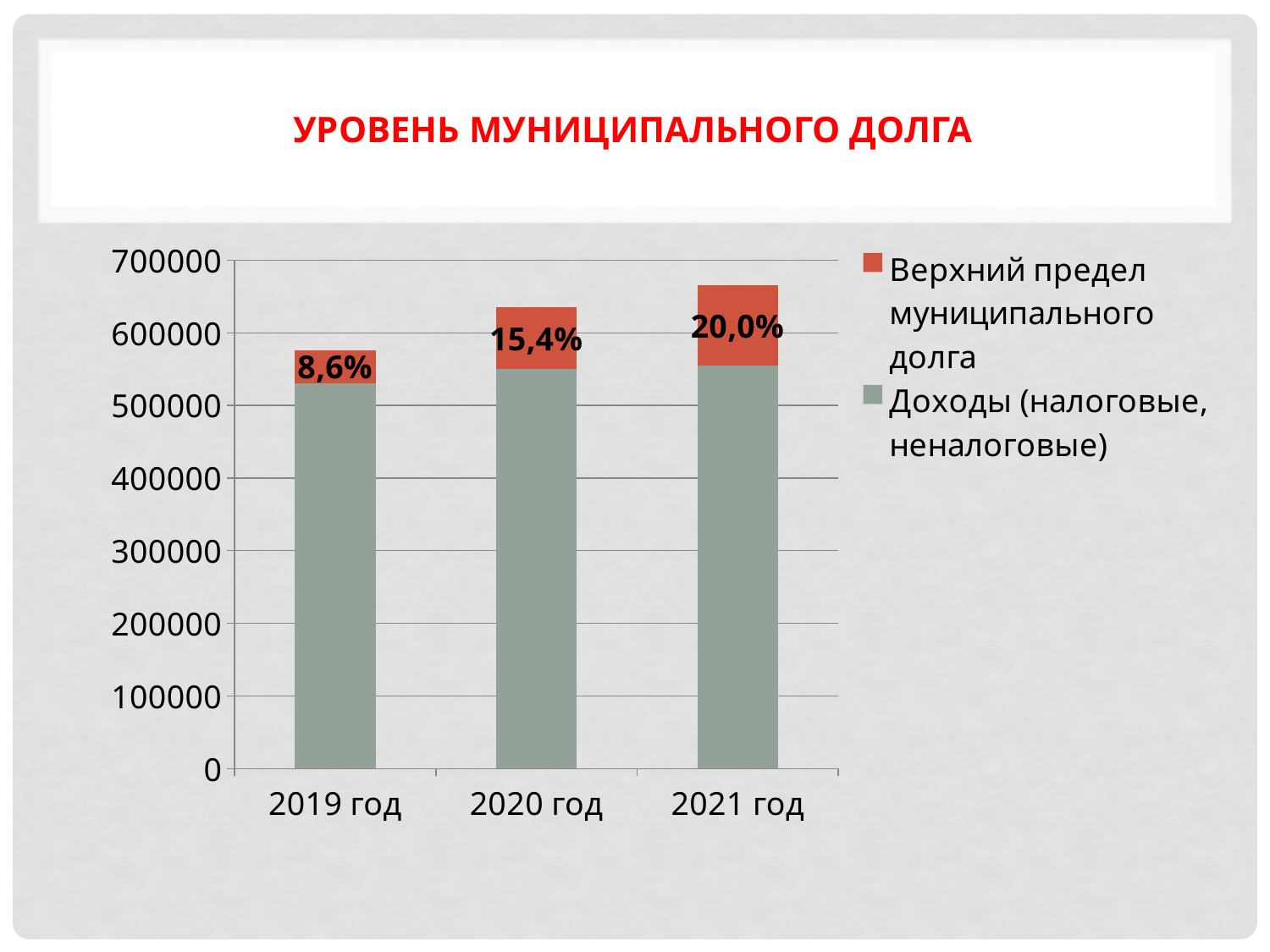
How many years (categories) are shown on the x axis? 3 Is the total height of the stacked bar for 2019 год greater or less than 600000? less Which year has the shortest stacked bar overall? 2019 год Do the percentage labels on the bars rise or fall from 2019 год to 2021 год? rise What kind of chart is shown on the slide? Stacked bar chart How many series does the legend list? 2 What percentage label is printed on the bar for 2021 год? 20,0% What percentage label is printed on the bar for 2019 год? 8,6% What percentage label is printed on the bar for 2020 год? 15,4% Which year has the tallest stacked bar overall? 2021 год Is the total height of the stacked bar for 2020 год greater or less than 600000? greater What is the title of the chart on the slide? УРОВЕНЬ МУНИЦИПАЛЬНОГО ДОЛГА